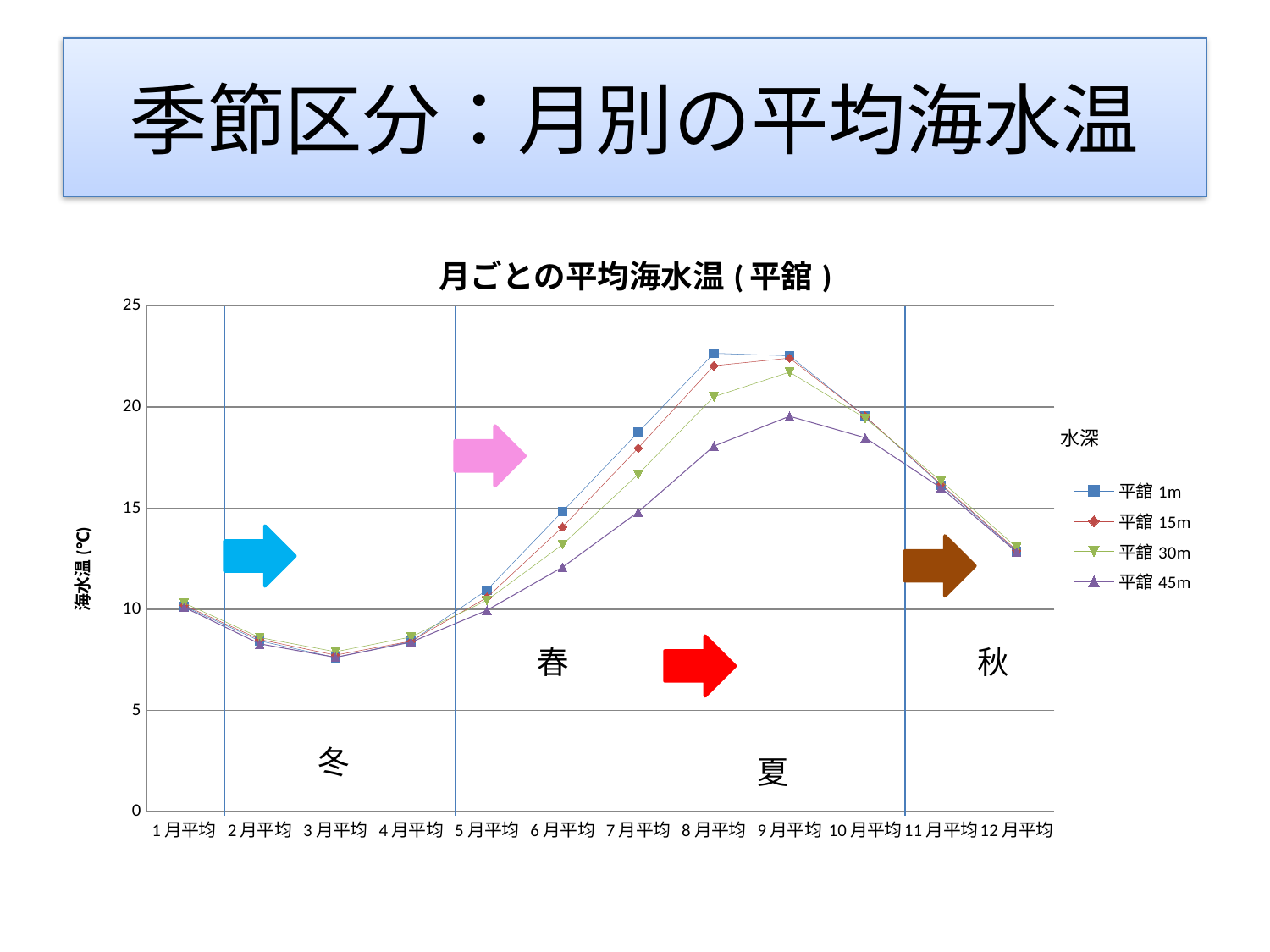
Is the value for 平舘 30m in 7月平均 greater or less than 15? greater How many series does the legend list? 4 Is the value for 平舘 45m in 8月平均 greater or less than 20? less In 8月平均, which is larger: 平舘 1m or 平舘 45m? 平舘 1m In which month does the 平舘 45m series reach its highest value? 9月平均 In which month does the 平舘 1m series reach its lowest value? 3月平均 What kind of chart is shown on the slide? line chart Is the value for 平舘 1m in 8月平均 greater or less than 20? greater What is the title of the chart? 月ごとの平均海水温(平舘) What is the legend title shown next to the series entries? 水深 How many months (categories) are plotted along the x axis? 12